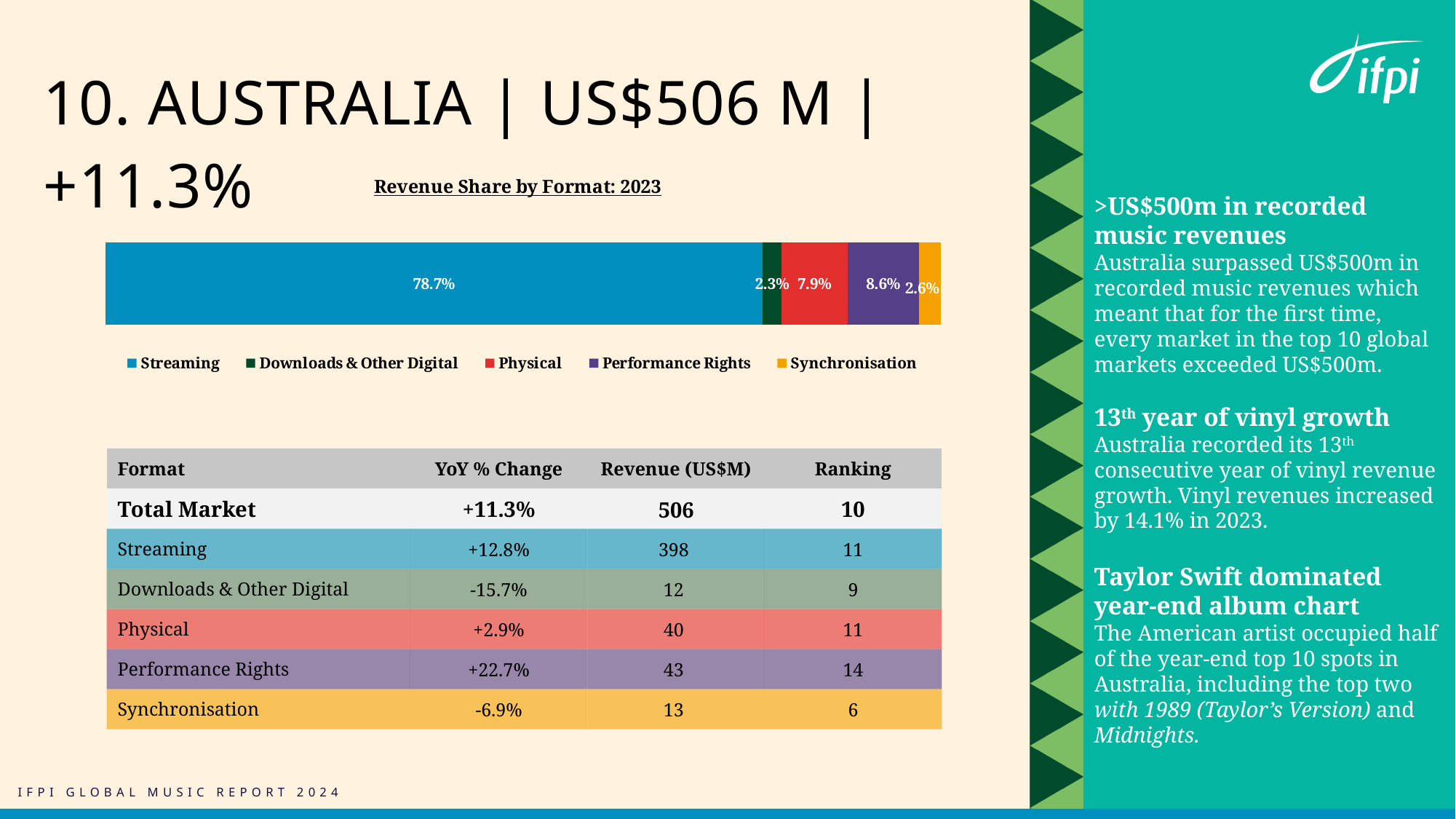
What is the revenue share for Streaming in the chart? 78.7% Which format has the smallest revenue share in the chart? Downloads & Other Digital What is the revenue share for Performance Rights in the chart? 8.6% What type of chart is shown under 'Revenue Share by Format: 2023'? Stacked bar chart What is the difference in revenue share between Streaming and Physical in the chart? 70.8% What is the revenue share for Physical in the chart? 7.9% What is the revenue share for Downloads & Other Digital in the chart? 2.3% What is the title of the chart on the slide? Revenue Share by Format: 2023 Which format has the largest revenue share in the chart? Streaming How many series does the chart legend list? 5 What is the revenue share for Synchronisation in the chart? 2.6% Which has a larger revenue share in the chart, Physical or Performance Rights? Performance Rights